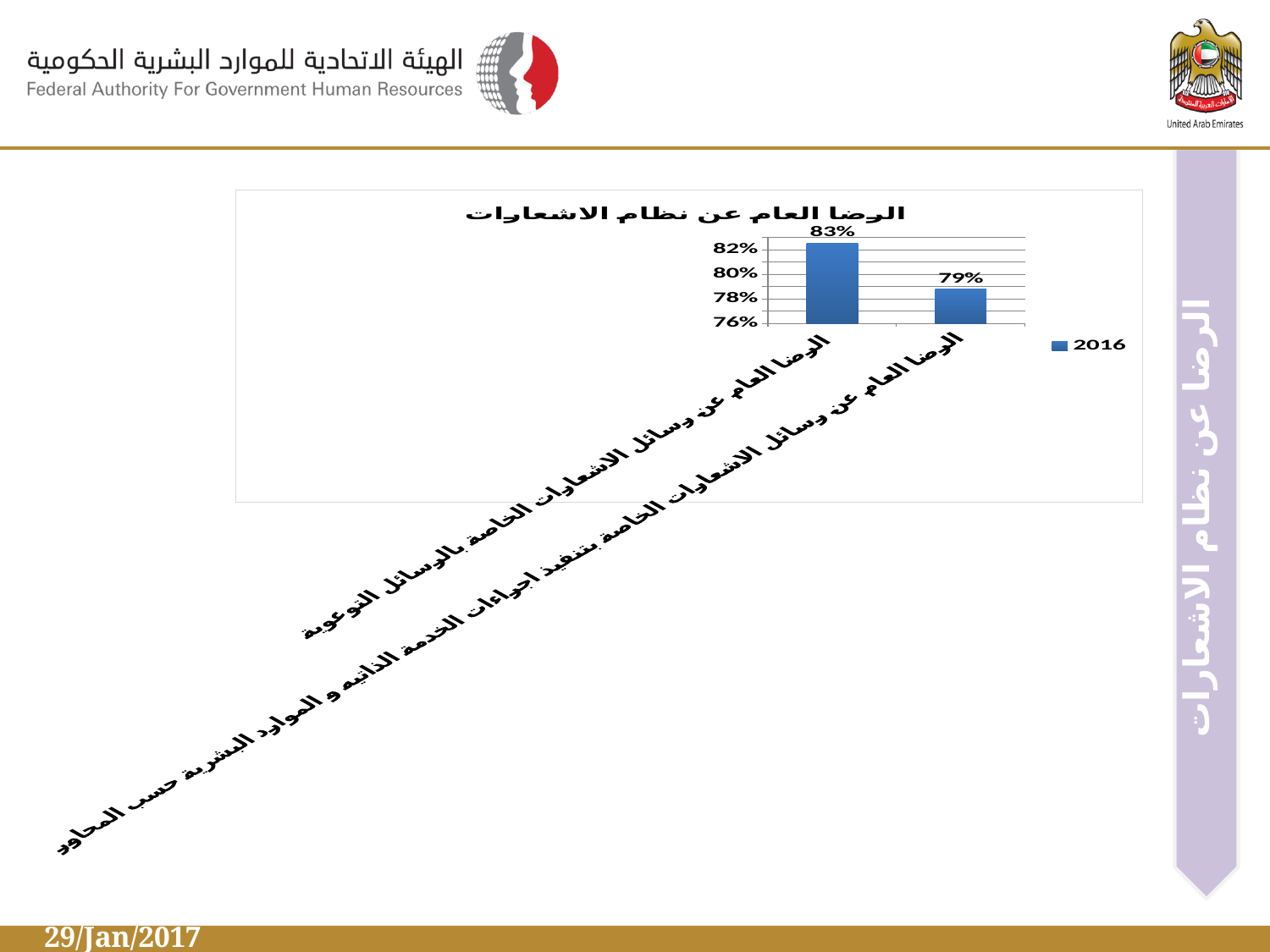
What year does the legend entry show? 2016 What is the value of the right bar (الرضا العام عن وسائل الاشعارات الخاصة بتنفيذ اجراءات الخدمة الذاتية و الموارد البشرية حسب المحاور)? 79% How many bars are plotted in the chart? 2 What is the value of the left bar (الرضا العام عن وسائل الاشعارات الخاصة بالوسائل التوعوية)? 83% What is the difference between the left bar and the right bar? 4% How many series does the chart legend list? 1 Which bar has the highest value? the left bar (الرضا العام عن وسائل الاشعارات الخاصة بالوسائل التوعوية) Is the value for the right bar greater or less than 80%? less Which bar has the lowest value? the right bar (الرضا العام عن وسائل الاشعارات الخاصة بتنفيذ اجراءات الخدمة الذاتية و الموارد البشرية حسب المحاور) What kind of chart is shown on the slide? bar chart What is the title of the chart? الرضا العام عن نظام الاشعارات Which is larger, the left bar or the right bar? the left bar